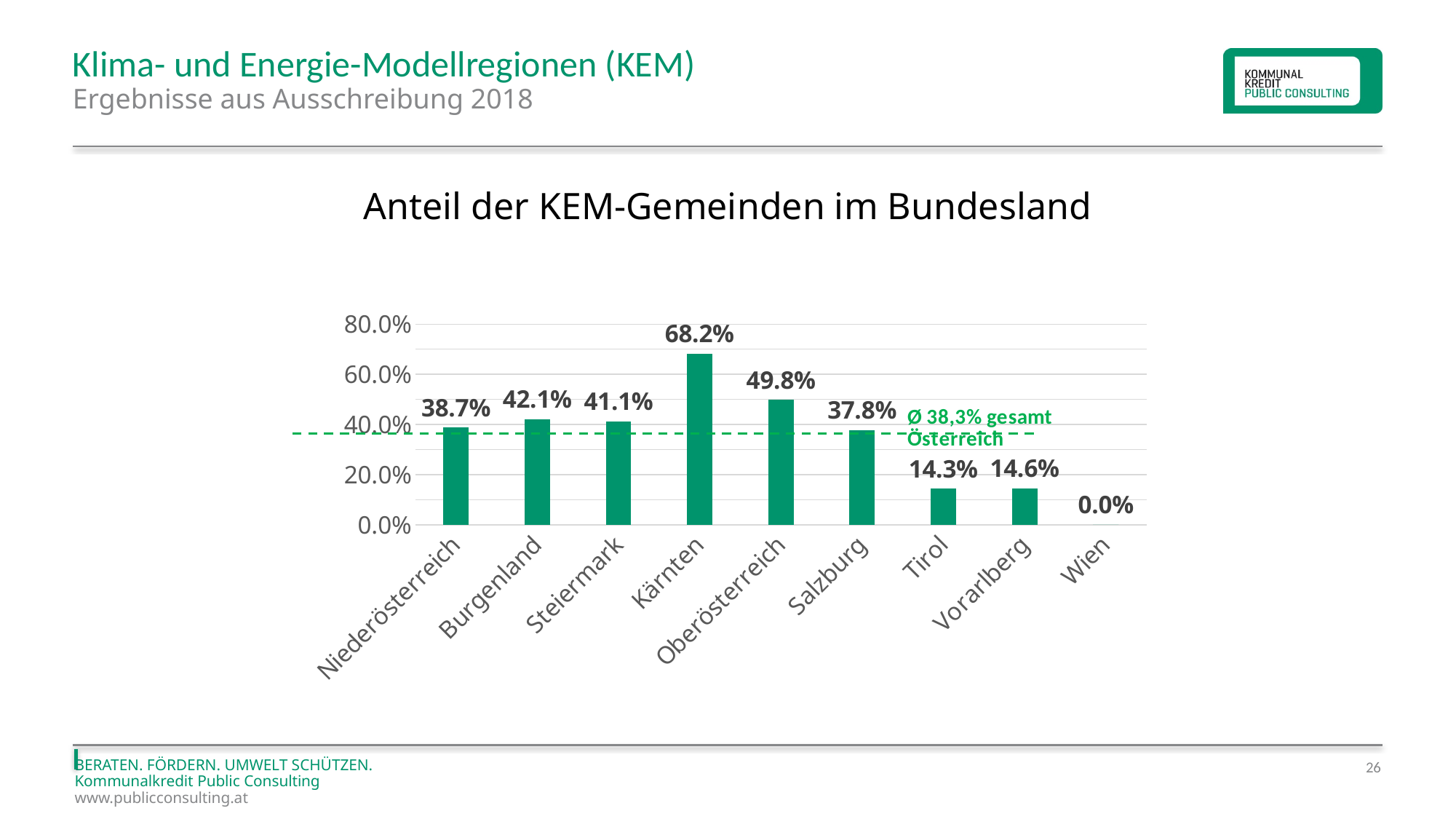
What is the title of the chart? Anteil der KEM-Gemeinden im Bundesland Which is larger, the value for Burgenland or the value for Steiermark? Burgenland What kind of chart is shown on the slide? bar chart Which Bundesland has the lowest share of KEM-Gemeinden? Wien Is the value for Salzburg greater or less than 40.0%? less What value does the dashed green line represent? Ø 38,3% gesamt Österreich Which Bundesland has the highest share of KEM-Gemeinden? Kärnten How many Bundesländer are shown on the x axis? 9 What is the value for Oberösterreich? 49.8% What is the value for Kärnten? 68.2% What is the value for Wien? 0.0% What is the difference between the values for Kärnten and Oberösterreich? 18.4%